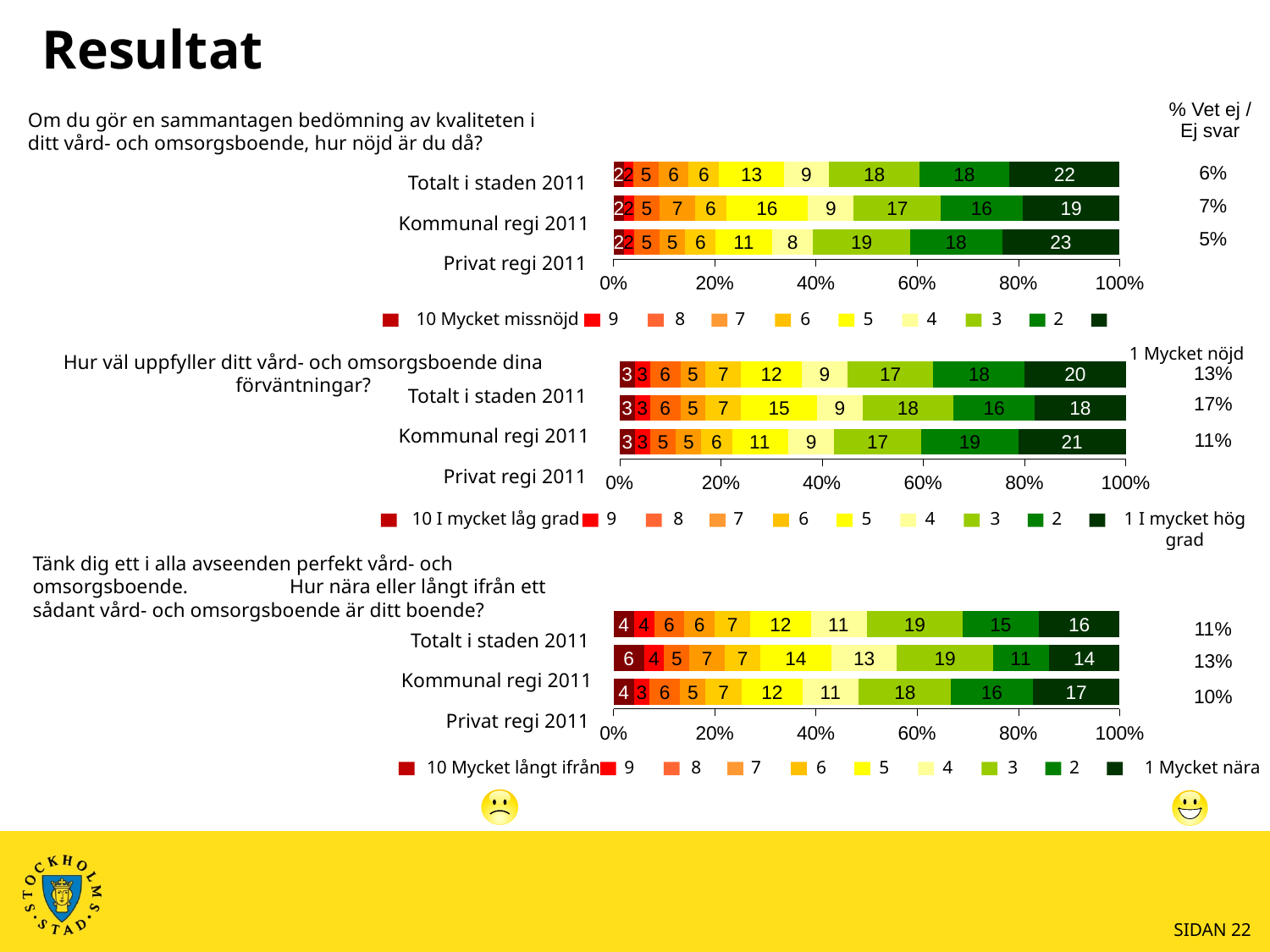
In the top chart, what is the difference between the '1 Mycket nöjd' values for Privat regi 2011 and Kommunal regi 2011? 4 In the middle chart, which category has the lowest value for the '1 I mycket hög grad' segment? Kommunal regi 2011 How many series does the legend of the middle chart list? 10 How many categories (bars) does the middle chart show? 3 In the top chart, which is larger for the '5' segment: Kommunal regi 2011 or Privat regi 2011? Kommunal regi 2011 In the middle chart, what is the value of the '1 I mycket hög grad' segment for Totalt i staden 2011? 20 In the top chart, what is the value of the '1 Mycket nöjd' segment for Privat regi 2011? 23 What is the '% Vet ej / Ej svar' value shown next to Kommunal regi 2011 in the top chart? 7% What kind of chart is the top chart on the slide? Stacked bar chart In the bottom chart, which category has the highest value for the '1 Mycket nära' segment? Privat regi 2011 In the top chart, which category has the highest value for the '1 Mycket nöjd' segment? Privat regi 2011 In the bottom chart, what is the value of the '4' segment for Kommunal regi 2011? 13